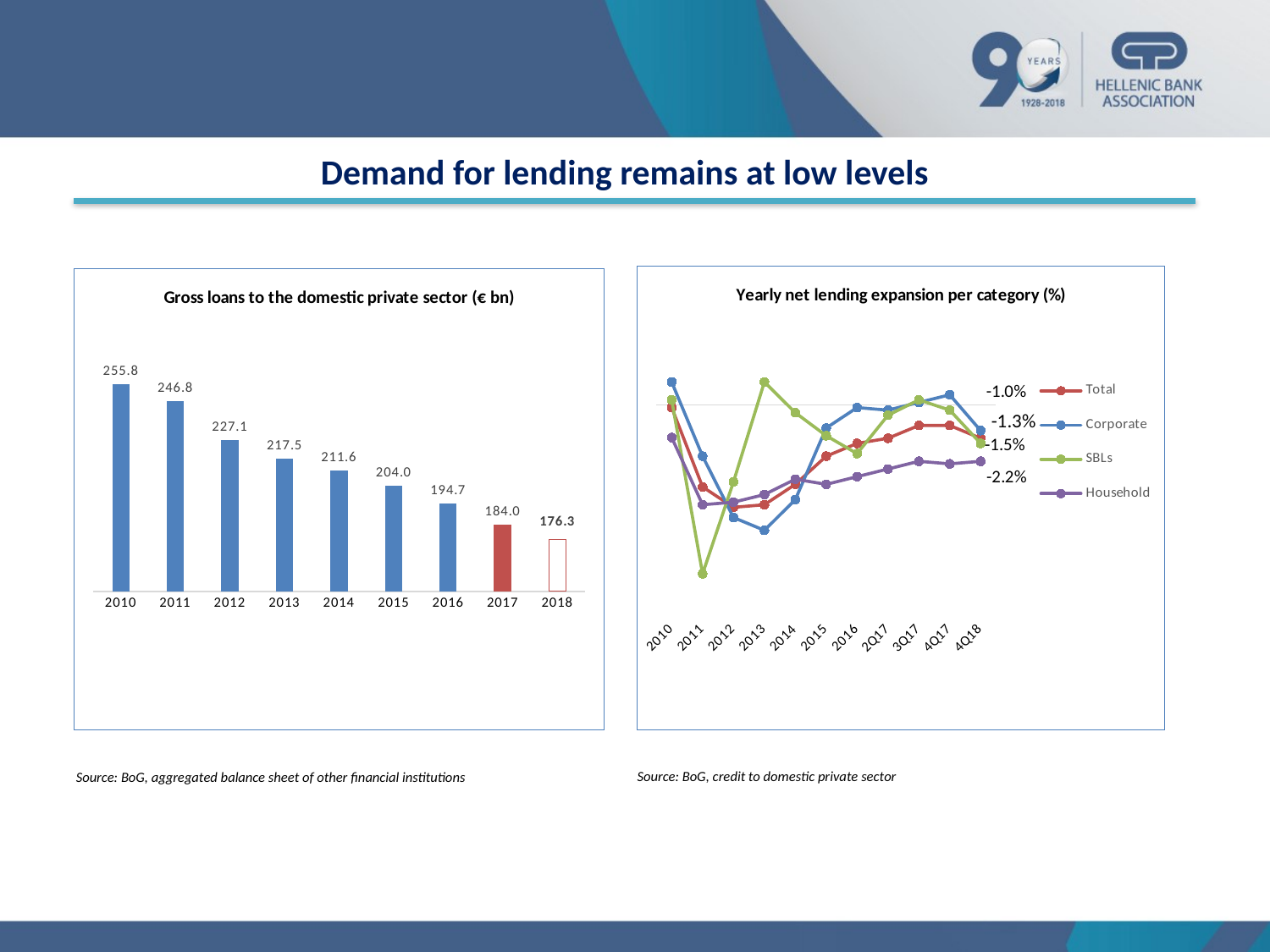
In the 'Gross loans to the domestic private sector (€ bn)' chart, what is the difference between the 2010 and 2018 values? 79.5 What kind of chart is 'Gross loans to the domestic private sector (€ bn)'? bar chart In the 'Gross loans to the domestic private sector (€ bn)' chart, do the values rise or fall from 2010 to 2018? fall What kind of chart is 'Yearly net lending expansion per category (%)'? line chart In the 'Gross loans to the domestic private sector (€ bn)' chart, what is the value for 2018? 176.3 In the 'Yearly net lending expansion per category (%)' chart, which series has the lowest value in 2011? SBLs In the 'Gross loans to the domestic private sector (€ bn)' chart, what is the value for 2010? 255.8 In the 'Gross loans to the domestic private sector (€ bn)' chart, what is the value for 2014? 211.6 In the 'Gross loans to the domestic private sector (€ bn)' chart, which year has the lowest value? 2018 How many series does the legend of the 'Yearly net lending expansion per category (%)' chart list? 4 In the 'Gross loans to the domestic private sector (€ bn)' chart, which year has the highest value? 2010 In the 'Gross loans to the domestic private sector (€ bn)' chart, how many years are shown? 9